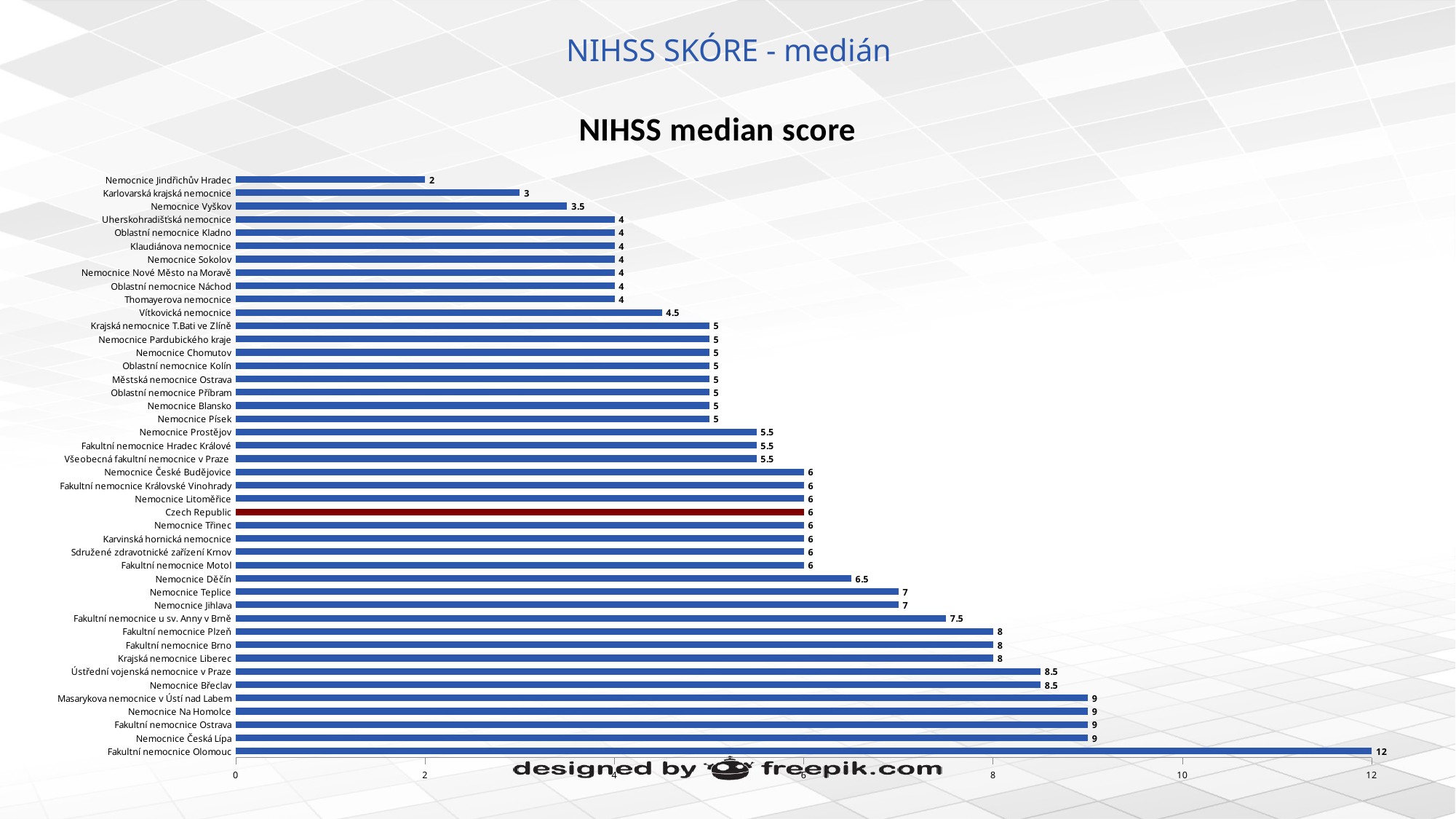
What is the NIHSS median score for Czech Republic? 6 What is the NIHSS median score for Nemocnice Vyškov? 3.5 Which hospital has the lowest NIHSS median score? Nemocnice Jindřichův Hradec Which has a higher NIHSS median score, Nemocnice Teplice or Nemocnice Prostějov? Nemocnice Teplice Which bar in the chart is coloured dark red instead of blue? Czech Republic What is the difference between the NIHSS median score of Fakultní nemocnice Olomouc and Nemocnice Jindřichův Hradec? 10 What is the NIHSS median score for Fakultní nemocnice Olomouc? 12 What is the NIHSS median score for Fakultní nemocnice u sv. Anny v Brně? 7.5 What type of chart is shown on the slide? Bar chart How many hospitals/categories are shown in the chart? 44 Which hospital has the highest NIHSS median score? Fakultní nemocnice Olomouc What is the difference between the NIHSS median score of Nemocnice Břeclav and Nemocnice Děčín? 2